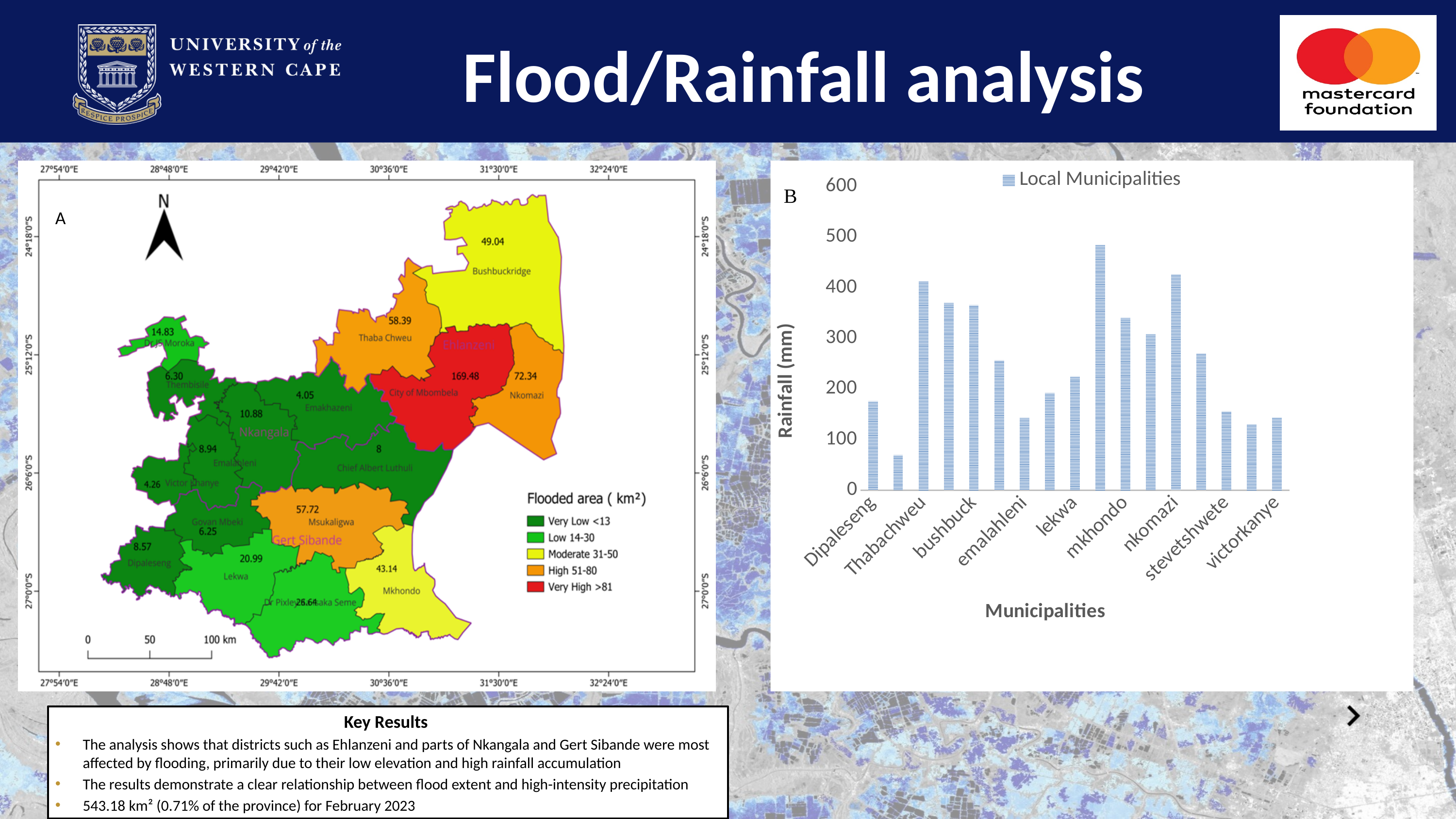
On chart B, is the rainfall value for victorkanye greater or less than 200? less On map A, what is the difference between the flooded area values for City of Mbombela and Nkomazi? 97.14 On chart B, is the rainfall value for emalahleni greater or less than 200? less On chart B, is the rainfall value for Thabachweu greater or less than 300? greater On chart B, what kind of chart is used to show rainfall by municipality? bar chart On chart B, which has the higher rainfall, Thabachweu or Dipaleseng? Thabachweu On chart B, what is the y-axis title? Rainfall (mm) On map A, which municipality has the largest flooded area value? City of Mbombela On map A, what is the flooded area value shown for City of Mbombela? 169.48 On chart B, how many series does the legend list? 1 On chart B, which has the higher rainfall, nkomazi or stevetshwete? nkomazi